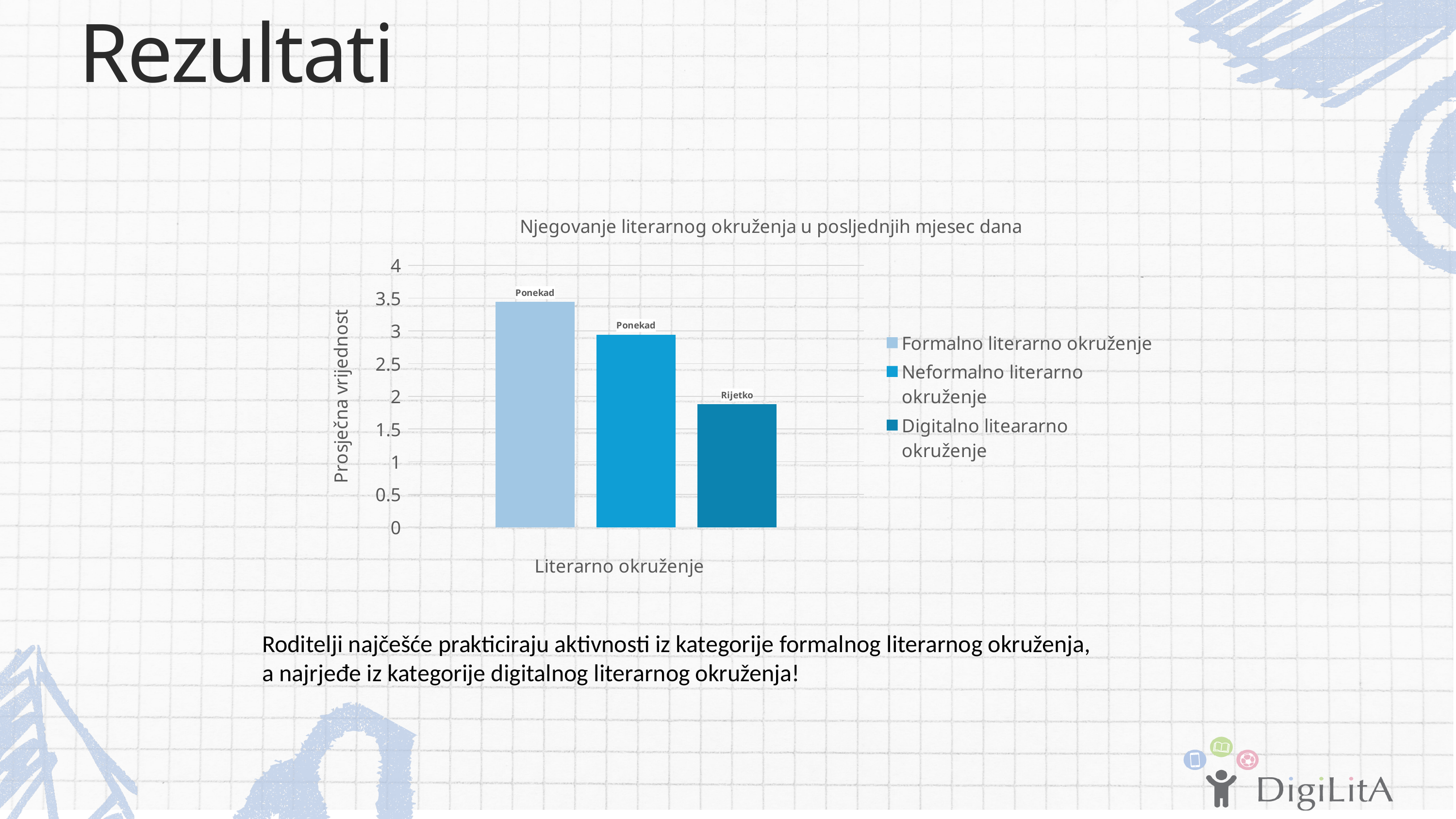
What data label is printed above the bar for Formalno literarno okruženje? Ponekad Is the value for Digitalno litearno okruženje greater or less than 2.5? less What data label is printed above the bar for Digitalno litearno okruženje? Rijetko Which series has the highest bar in the chart? Formalno literarno okruženje Which series has the lowest bar in the chart? Digitalno liteararno okruženje How many series does the chart legend list? 3 Which is larger, the value for Formalno literarno okruženje or the value for Neformalno literarno okruženje? Formalno literarno okruženje Is the value for Neformalno literarno okruženje greater or less than 2.5? greater Is the value for Formalno literarno okruženje greater or less than 3? greater What type of chart is shown on the slide? bar chart What is the title of the chart? Njegovanje literarnog okruženja u posljednjih mjesec dana What is the label of the vertical axis of the chart? Prosječna vrijednost